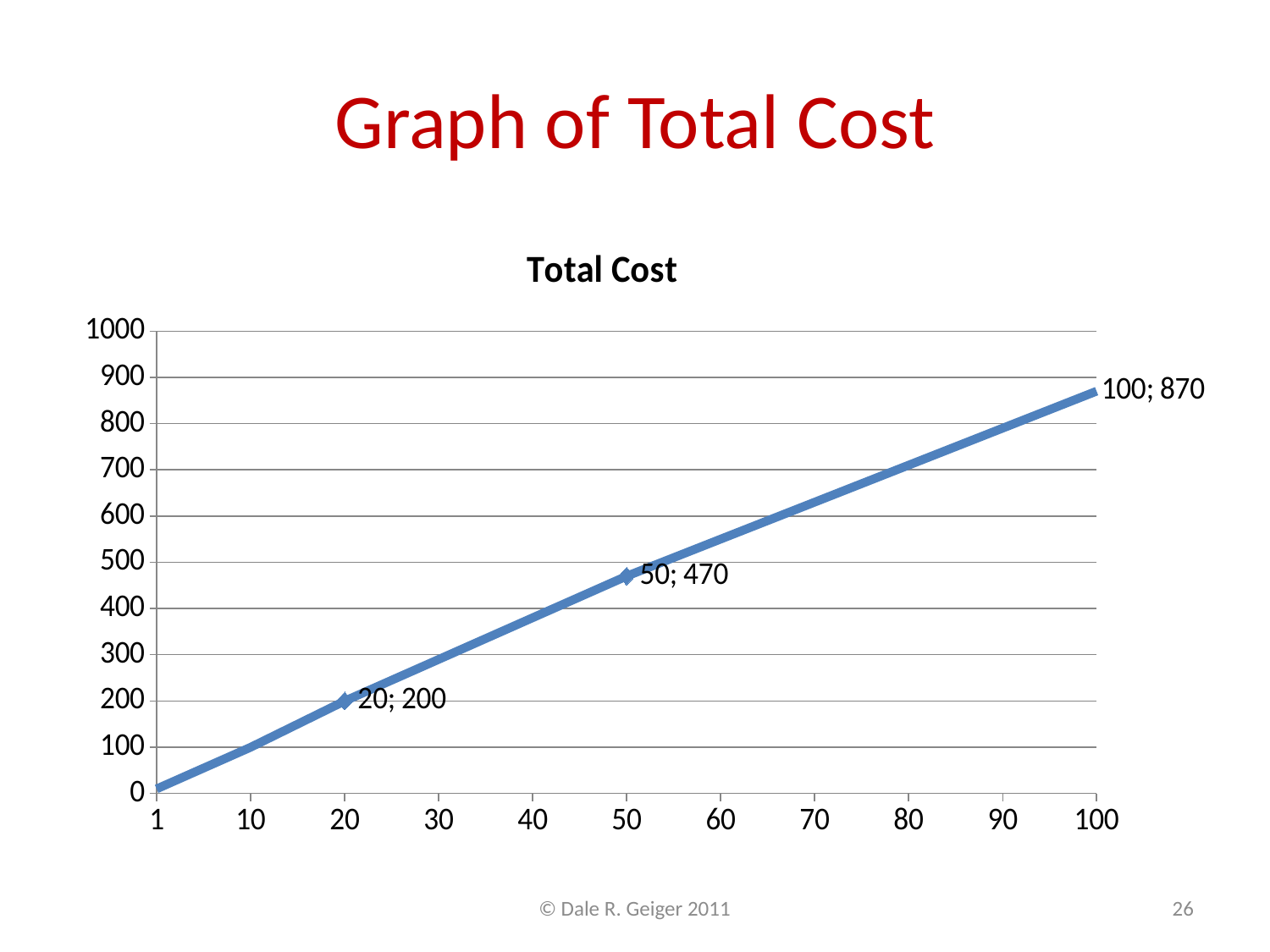
Which labelled point has the lowest total cost? 20; 200 Is the total cost at x = 10 greater or less than 200? less What kind of chart is shown on the slide? line chart What is the total cost at x = 100? 870 What is the title of the chart? Total Cost Is the total cost at x = 80 greater or less than 600? greater What is the difference in total cost between x = 100 and x = 50? 400 Which labelled point has the highest total cost? 100; 870 What is the difference in total cost between x = 50 and x = 20? 270 Does the total cost rise or fall as x increases? rises What is the total cost at x = 50? 470 What is the total cost at x = 20? 200